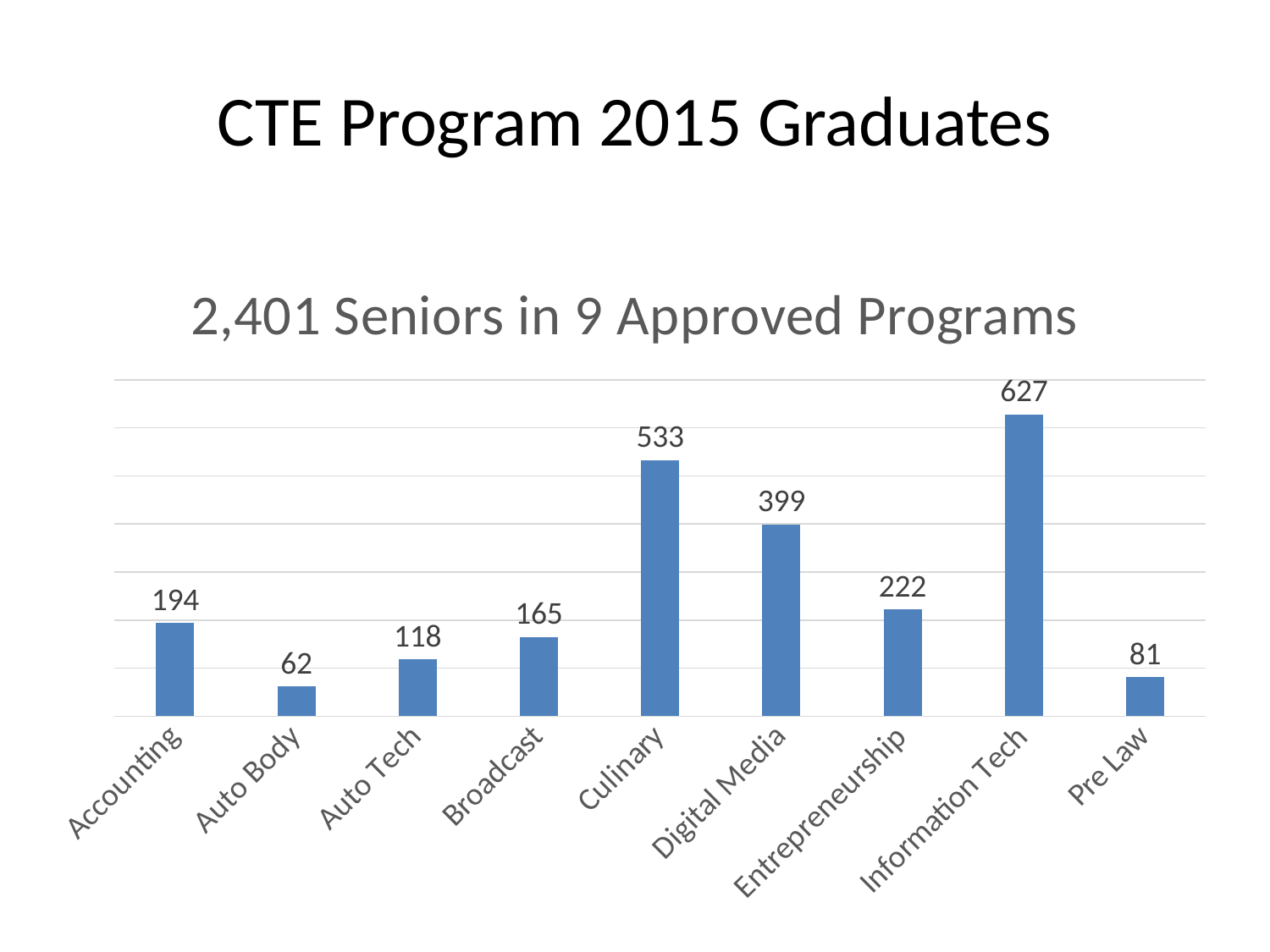
How many programs are shown on the x axis? 9 What kind of chart is shown on the slide? Bar chart What is the title of the chart? 2,401 Seniors in 9 Approved Programs Which program has the lowest value? Auto Body Which is larger, the value for Digital Media or the value for Entrepreneurship? Digital Media What is the value for Auto Body? 62 What is the difference between the values for Accounting and Broadcast? 29 What is the difference between the values for Information Tech and Culinary? 94 Which program has the highest value? Information Tech What is the value for Pre Law? 81 What is the value for Entrepreneurship? 222 What is the value for Culinary? 533